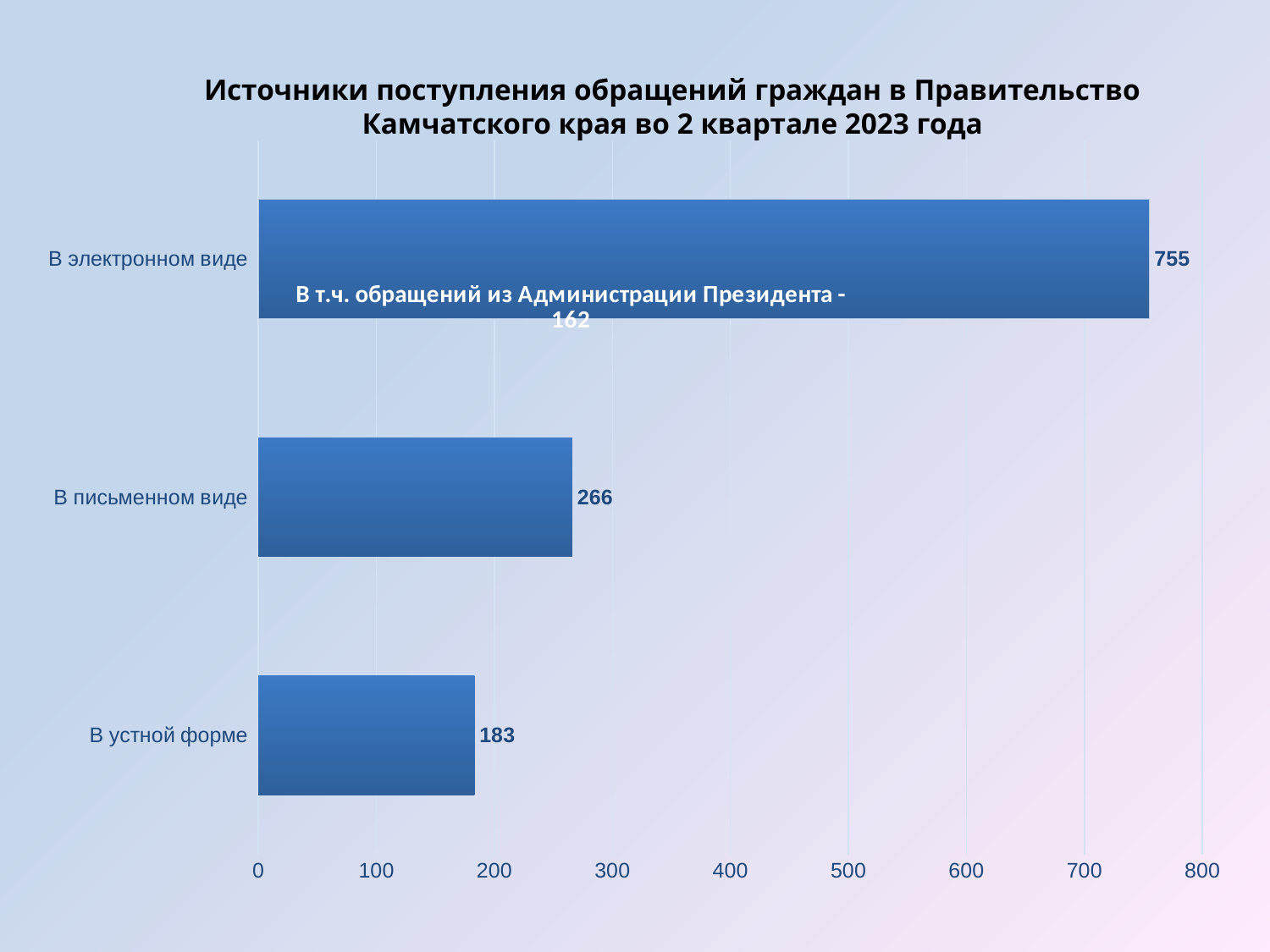
Which is larger: the value for «В письменном виде» or «В устной форме»? В письменном виде Which category has the lowest value? В устной форме Which category has the highest value? В электронном виде According to the annotation inside the top bar, how many of the electronic appeals came from the Administration of the President? 162 Is the value for «В электронном виде» greater or less than 700? greater How many categories are shown in the chart? 3 What kind of chart is shown on the slide? bar chart What is the difference between the values for «В электронном виде» and «В письменном виде»? 489 What is the value for «В электронном виде»? 755 What is the value for «В письменном виде»? 266 What is the value for «В устной форме»? 183 What is the difference between the values for «В письменном виде» and «В устной форме»? 83